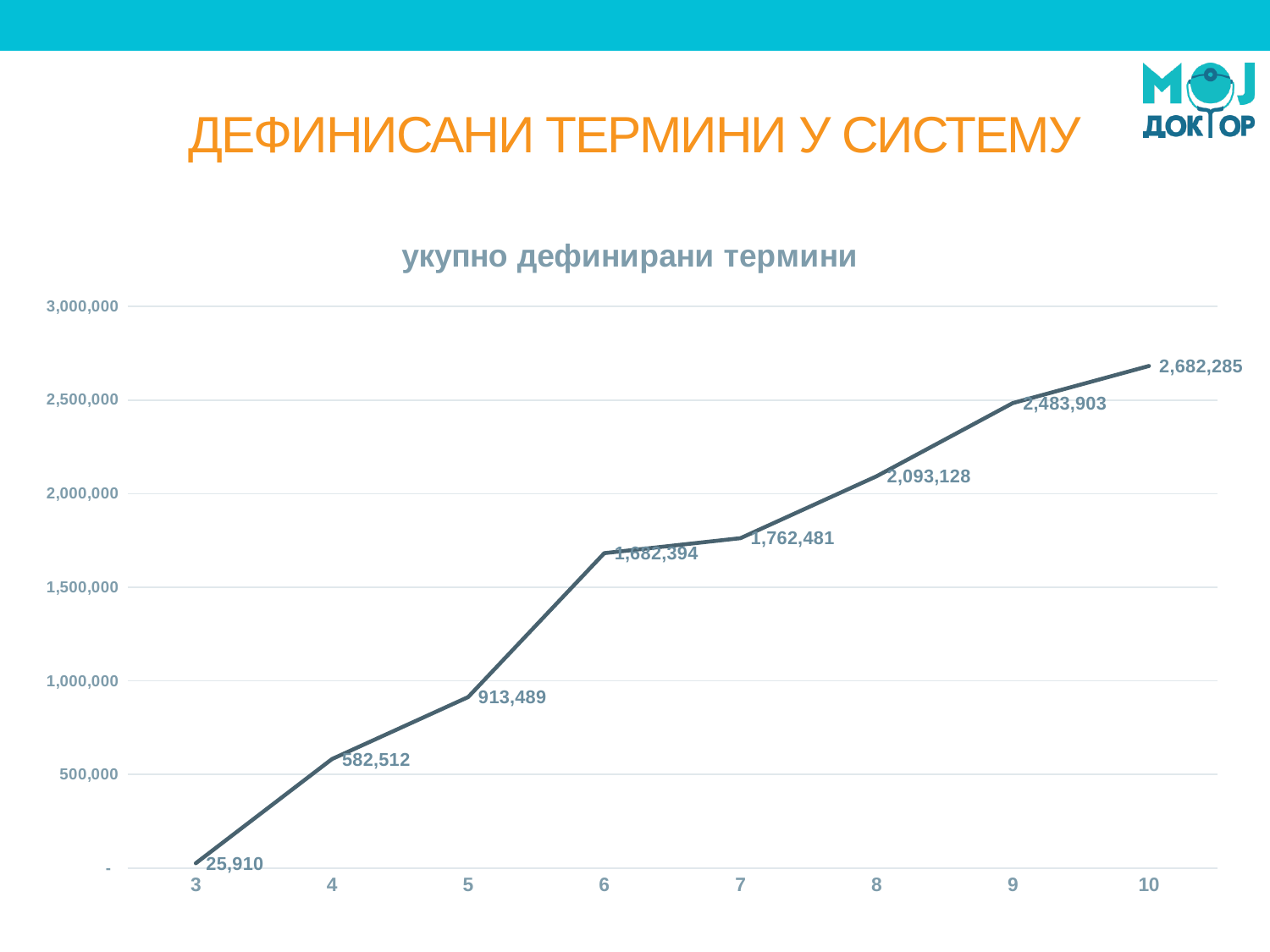
How many data points are plotted on the line? 8 What is the value at x = 8? 2,093,128 What is the value at x = 10? 2,682,285 Do the values rise or fall as x increases from 3 to 10? rise What is the value at x = 3? 25,910 What kind of chart is shown? line chart What is the difference between the values at x = 7 and x = 6? 80,087 What is the value at x = 6? 1,682,394 At which x value is the plotted value highest? 10 Which is larger, the value at x = 5 or the value at x = 4? x = 5 At which x value is the plotted value lowest? 3 What is the difference between the values at x = 10 and x = 9? 198,382